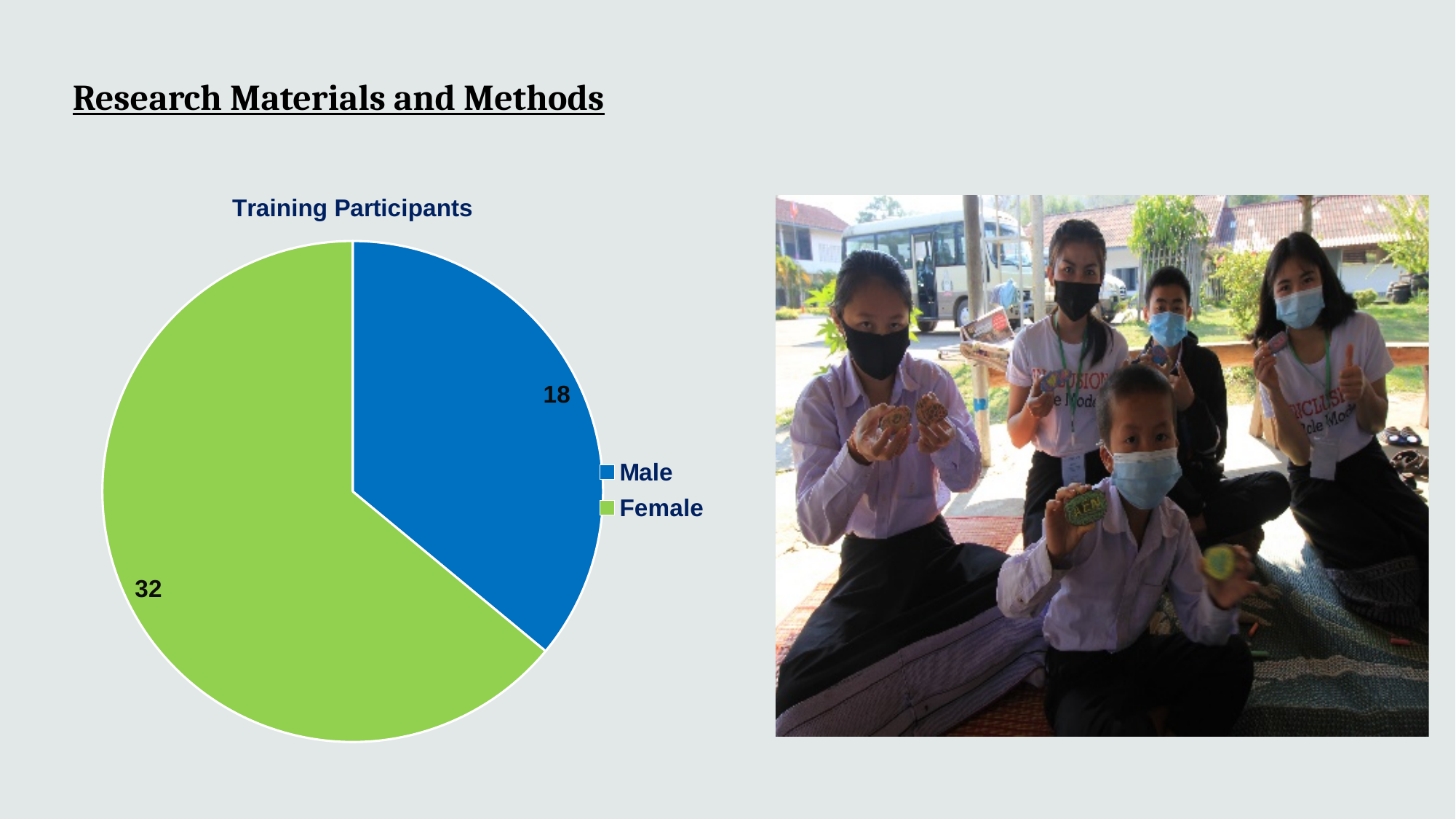
How many categories does the pie chart show? 2 How many training participants are Female? 32 What is the title of the chart? Training Participants What is the total number of training participants shown in the pie chart? 50 What colour is the Male slice? blue Which category has the largest slice of the pie? Female How many training participants are Male? 18 What share of the pie does the Female slice represent? 64% What kind of chart is shown on the slide? pie chart Which is larger, the Male slice or the Female slice? Female What is the difference between the number of Female and Male participants? 14 Which category has the smallest slice of the pie? Male